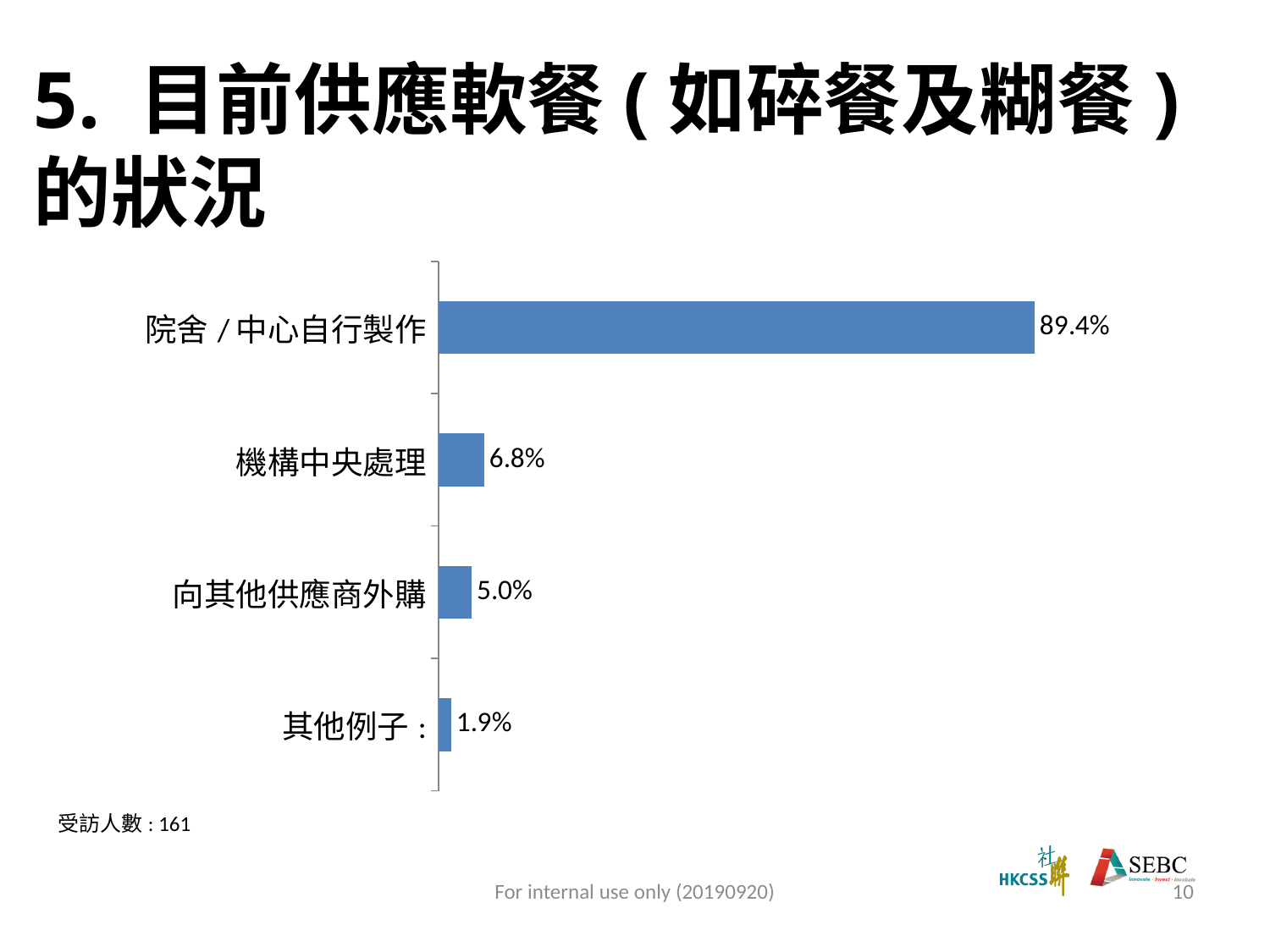
What is the difference between the values for 院舍／中心自行製作 and 機構中央處理? 82.6% Which is larger, the value for 機構中央處理 or the value for 向其他供應商外購? 機構中央處理 What is the value for 院舍／中心自行製作? 89.4% What is the value for 機構中央處理? 6.8% What is the difference between the values for 機構中央處理 and 向其他供應商外購? 1.8% What is the value for 其他例子? 1.9% Which category has the highest value? 院舍／中心自行製作 How many categories are shown in the chart? 4 What kind of chart is shown on the slide? bar chart Which category has the lowest value? 其他例子 What is the value for 向其他供應商外購? 5.0% How many respondents (受訪人數) are noted below the chart? 161